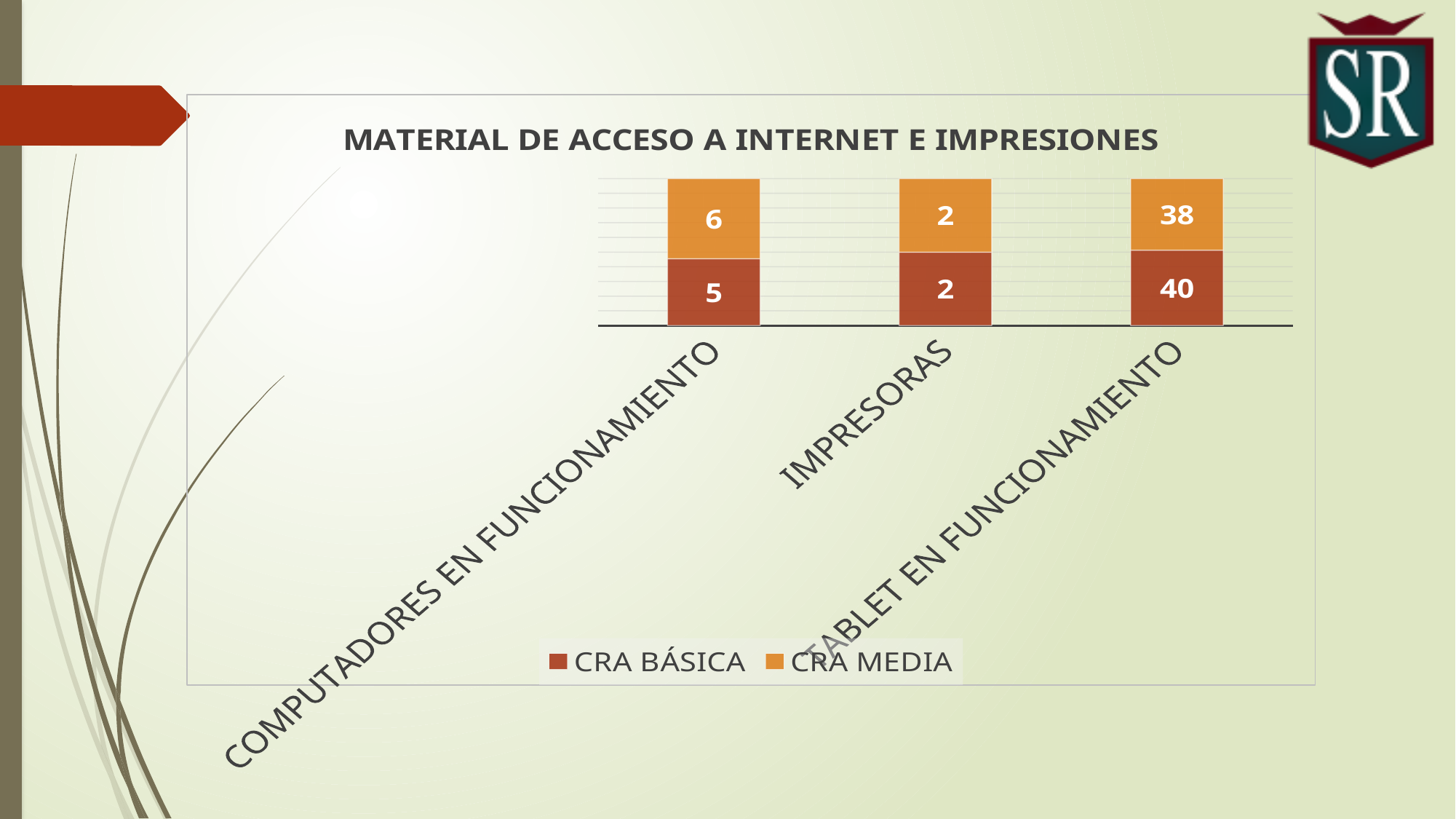
What is the combined total of CRA BÁSICA and CRA MEDIA for TABLET EN FUNCIONAMIENTO? 78 How many categories are shown on the x axis? 3 Which category has the highest CRA MEDIA value? TABLET EN FUNCIONAMIENTO What is the CRA BÁSICA value for IMPRESORAS? 2 What is the difference between the CRA BÁSICA and CRA MEDIA values for TABLET EN FUNCIONAMIENTO? 2 What is the CRA MEDIA value for COMPUTADORES EN FUNCIONAMIENTO? 6 What is the CRA BÁSICA value for TABLET EN FUNCIONAMIENTO? 40 Which category has the lowest CRA BÁSICA value? IMPRESORAS How many series does the legend list? 2 For COMPUTADORES EN FUNCIONAMIENTO, which series has the larger value, CRA BÁSICA or CRA MEDIA? CRA MEDIA What is the title of the chart? MATERIAL DE ACCESO A INTERNET E IMPRESIONES What is the combined total of CRA BÁSICA and CRA MEDIA for COMPUTADORES EN FUNCIONAMIENTO? 11